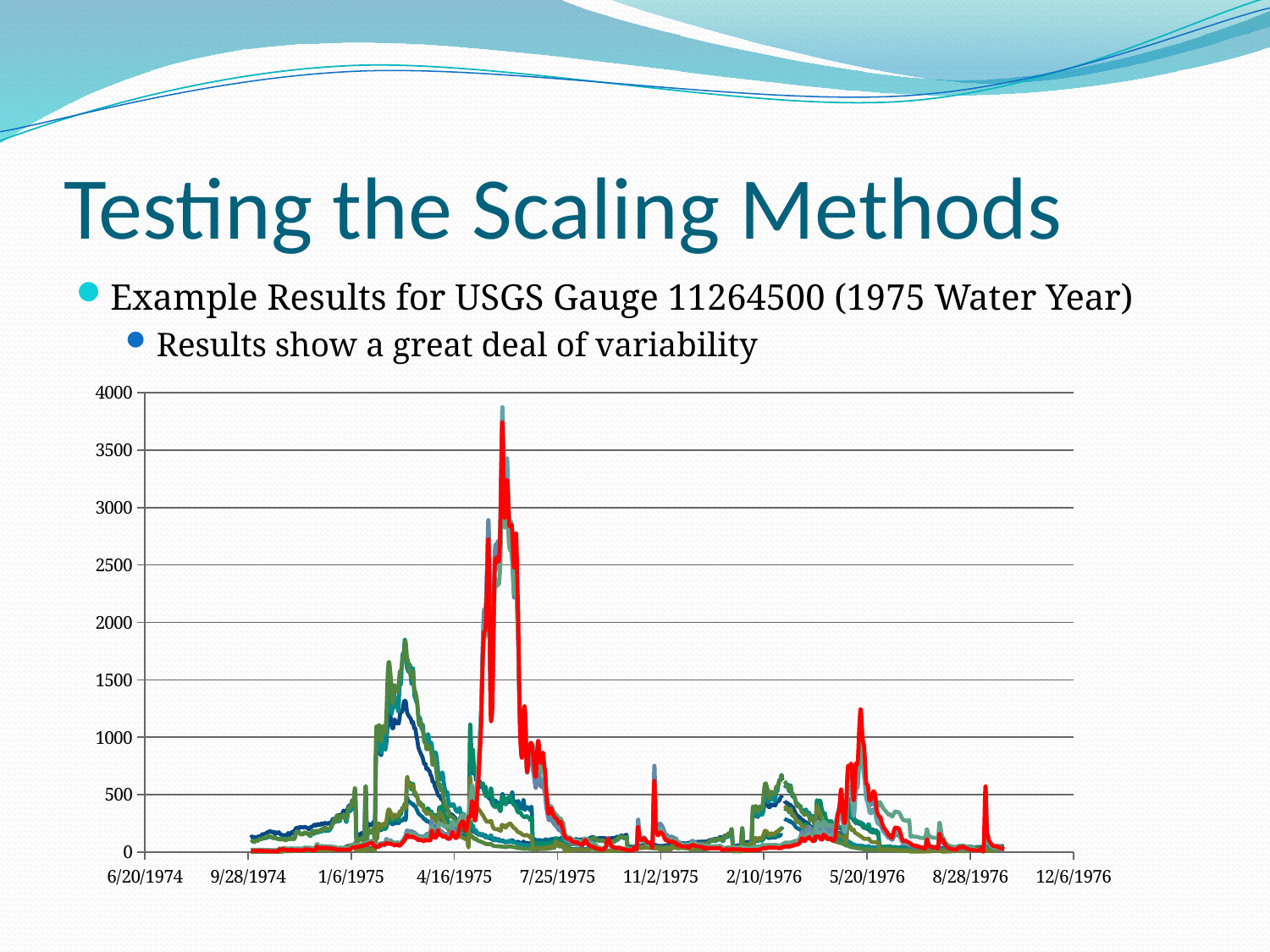
Is the spike near 11/2/1975 greater or less than 1000? less Which is higher: the peak between 4/16/1975 and 7/25/1975, or the peak between 1/6/1975 and 4/16/1975? the peak between 4/16/1975 and 7/25/1975 Is the peak of the first cluster of lines, between 1/6/1975 and 4/16/1975, greater or less than 2000? less Do the values of the red line rise or fall between 7/25/1975 and 11/2/1975? fall Is the red spike near 8/28/1976 greater or less than 1000? less What is the first date label on the horizontal axis? 6/20/1974 What kind of chart is shown on the slide? line chart How many date labels are shown on the horizontal axis? 10 What is the maximum value shown on the vertical axis? 4000